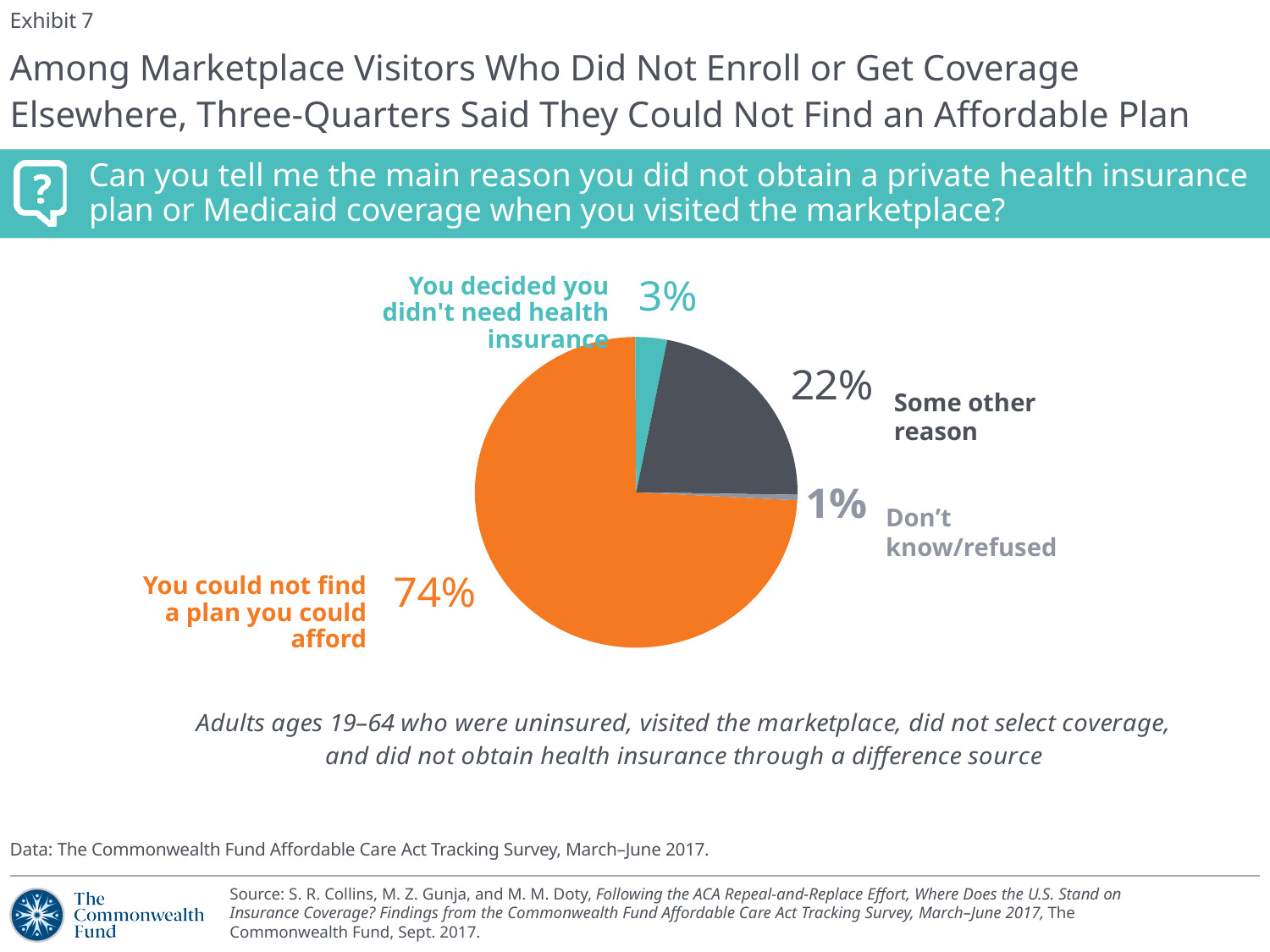
What is the difference in percentage points between 'You could not find a plan you could afford' and 'Some other reason'? 52 How many categories are shown in the pie chart? 4 Which is larger: the share for 'Some other reason' or the share for 'You decided you didn't need health insurance'? Some other reason What share of respondents said they could not find a plan they could afford? 74% What percentage of respondents answered 'Don't know/refused'? 1% Which category has the smallest slice of the pie? Don't know/refused What type of chart is shown on the slide? Pie chart What percentage of respondents gave 'Some other reason'? 22% Which reason has the largest share of the pie? You could not find a plan you could afford What share of respondents decided they didn't need health insurance? 3% What is the combined share of 'You decided you didn't need health insurance' and 'Don't know/refused'? 4% What colour is the slice for 'You could not find a plan you could afford'? Orange